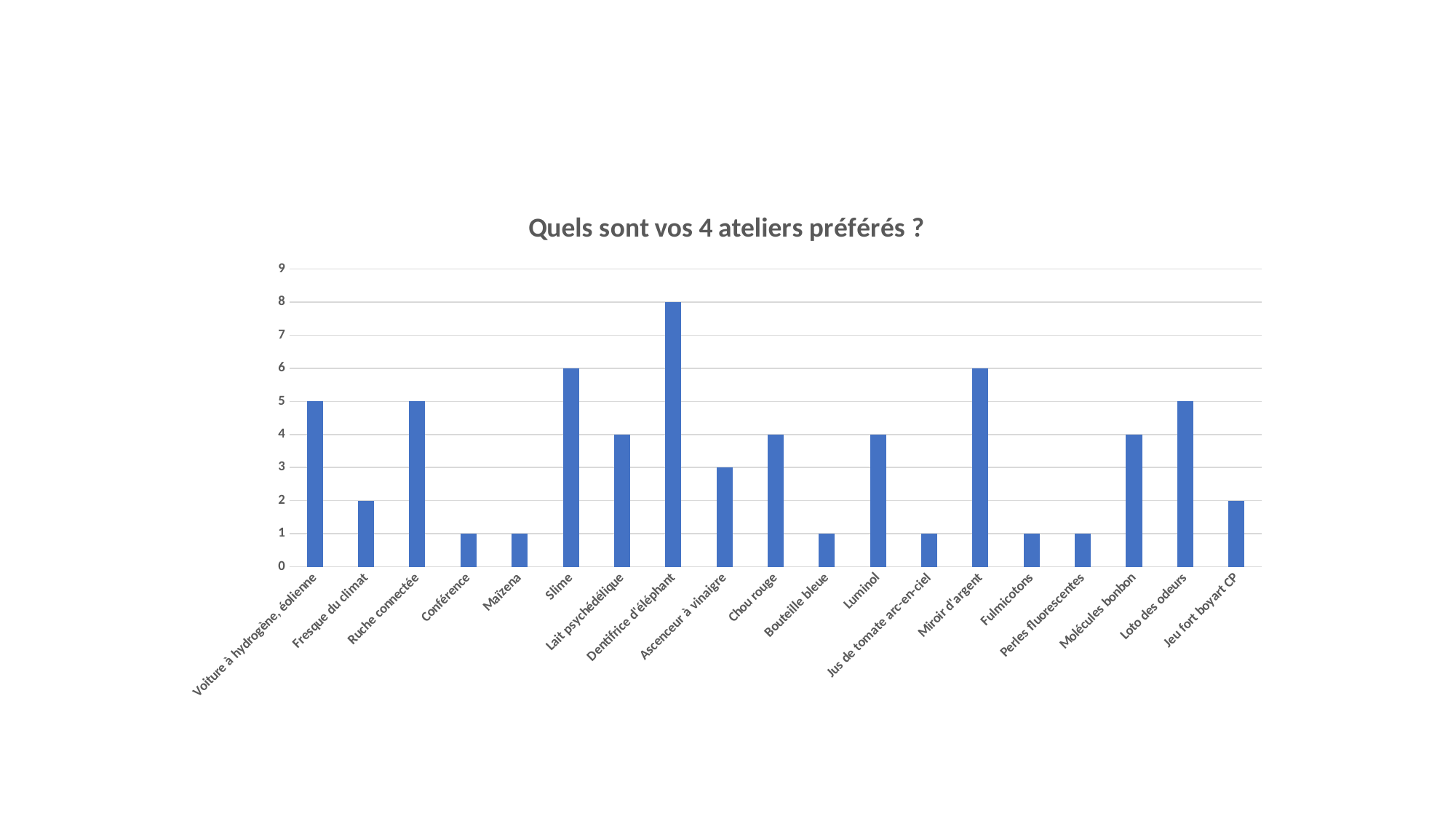
What is the difference between the values for Dentifrice d'éléphant and Miroir d'argent? 2 What is the value for Loto des odeurs? 5 Which workshop received the highest number of votes? Dentifrice d'éléphant How many categories are shown on the x axis? 19 Which is larger, the value for Fresque du climat or the value for Ruche connectée? Ruche connectée What is the value for Slime? 6 What is the value for Ascenceur à vinaigre? 3 What type of chart is shown on the slide? Bar chart What is the value for Jeu fort boyart CP? 2 What is the value for Dentifrice d'éléphant? 8 What is the title of the chart? Quels sont vos 4 ateliers préférés ? Is the value for Lait psychédélique greater or less than 5? less